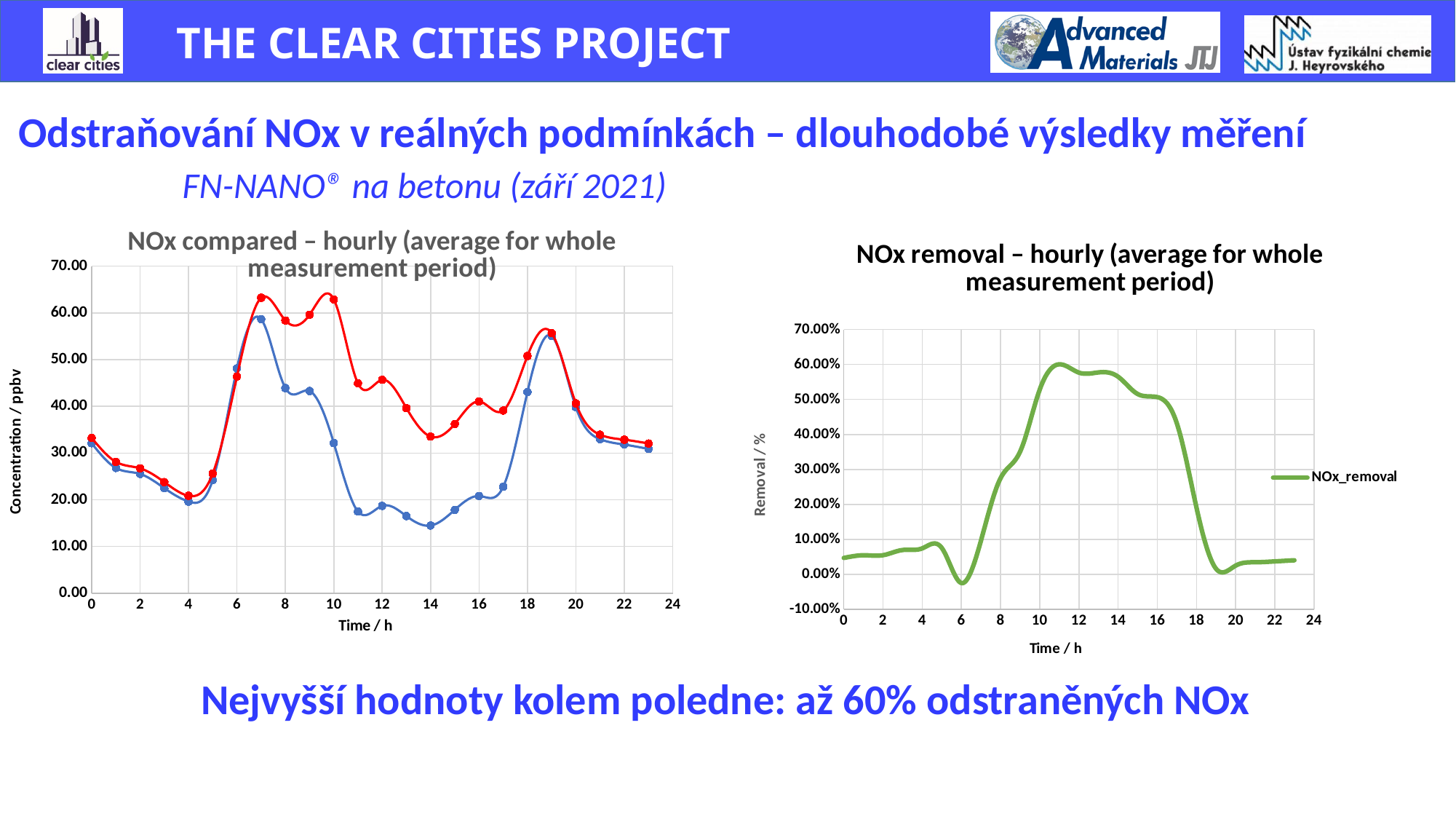
In the 'NOx removal – hourly' chart, is the removal value at hour 6 greater or less than 0.00%? less In the 'NOx removal – hourly' chart, how many series does the legend list? 1 In the 'NOx compared – hourly' chart, does the blue line rise or fall between hour 10 and hour 14? fall In the 'NOx removal – hourly' chart, what is the name of the series shown in the legend? NOx_removal In the 'NOx compared – hourly' chart, how many lines are plotted? 2 In the 'NOx removal – hourly' chart, is the removal value at hour 20 greater or less than 10.00%? less What kind of chart is the 'NOx compared – hourly' chart on the left? line chart In the 'NOx removal – hourly' chart, does the removal value rise or fall between hour 6 and hour 11? rise In the 'NOx compared – hourly' chart, is the blue line's value at hour 14 greater or less than 20.00? less What kind of chart is the 'NOx removal – hourly' chart on the right? line chart